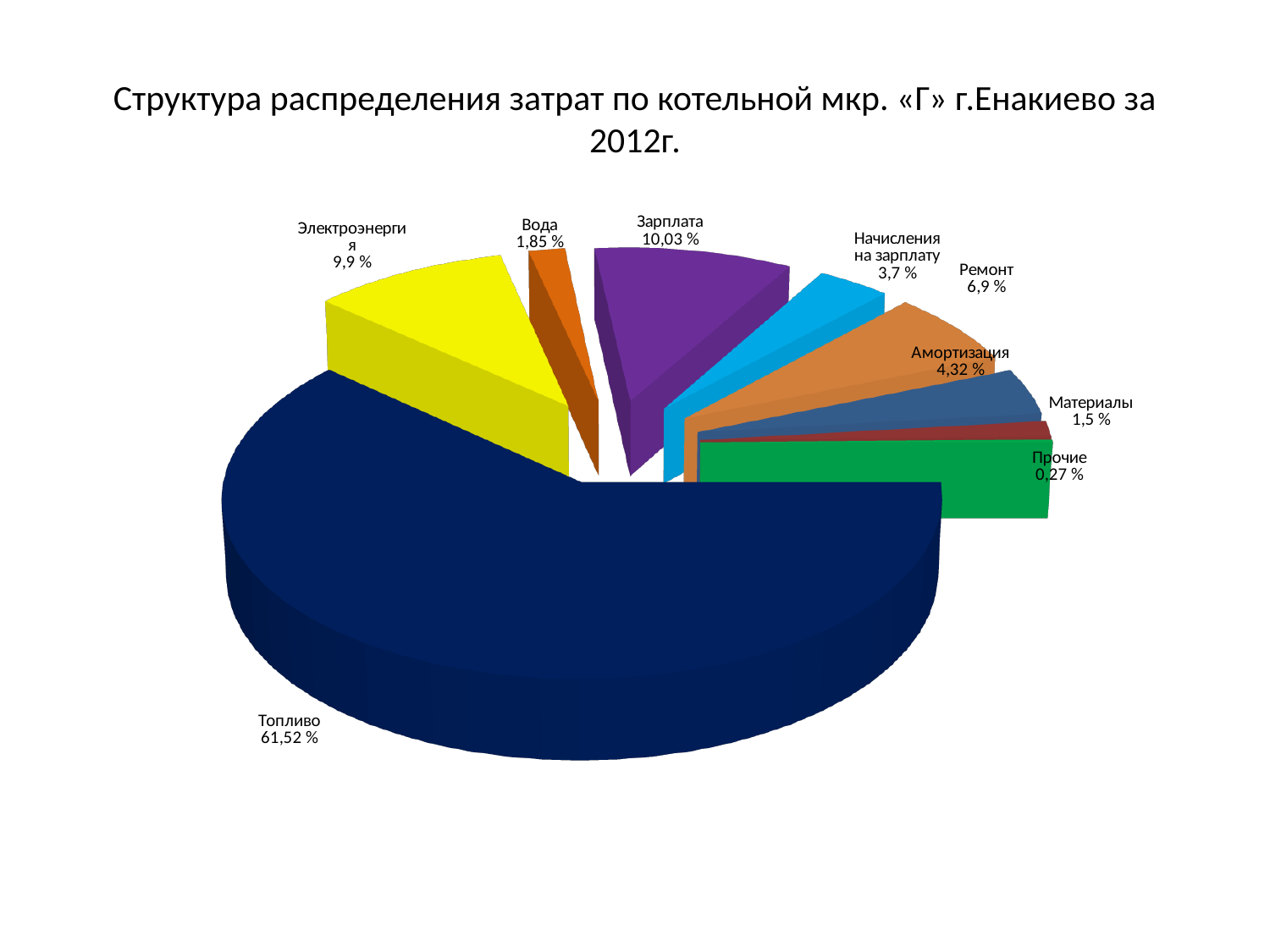
What is the value shown for Амортизация? 4,32 % Which category has the smallest share of the pie? Прочие What colour is the Топливо slice? dark blue Which category has the largest share of the pie? Топливо Which is larger, Электроэнергия or Ремонт? Электроэнергия What is the difference between the shares of Зарплата and Электроэнергия? 0,13 % How many categories are shown in the pie chart? 9 What is the value shown for Начисления на зарплату? 3,7 % What share of costs does Топливо account for? 61,52 % What kind of chart is shown on the slide? pie chart What is the difference between the shares of Ремонт and Вода? 5,05 % What is the value shown for Зарплата? 10,03 %